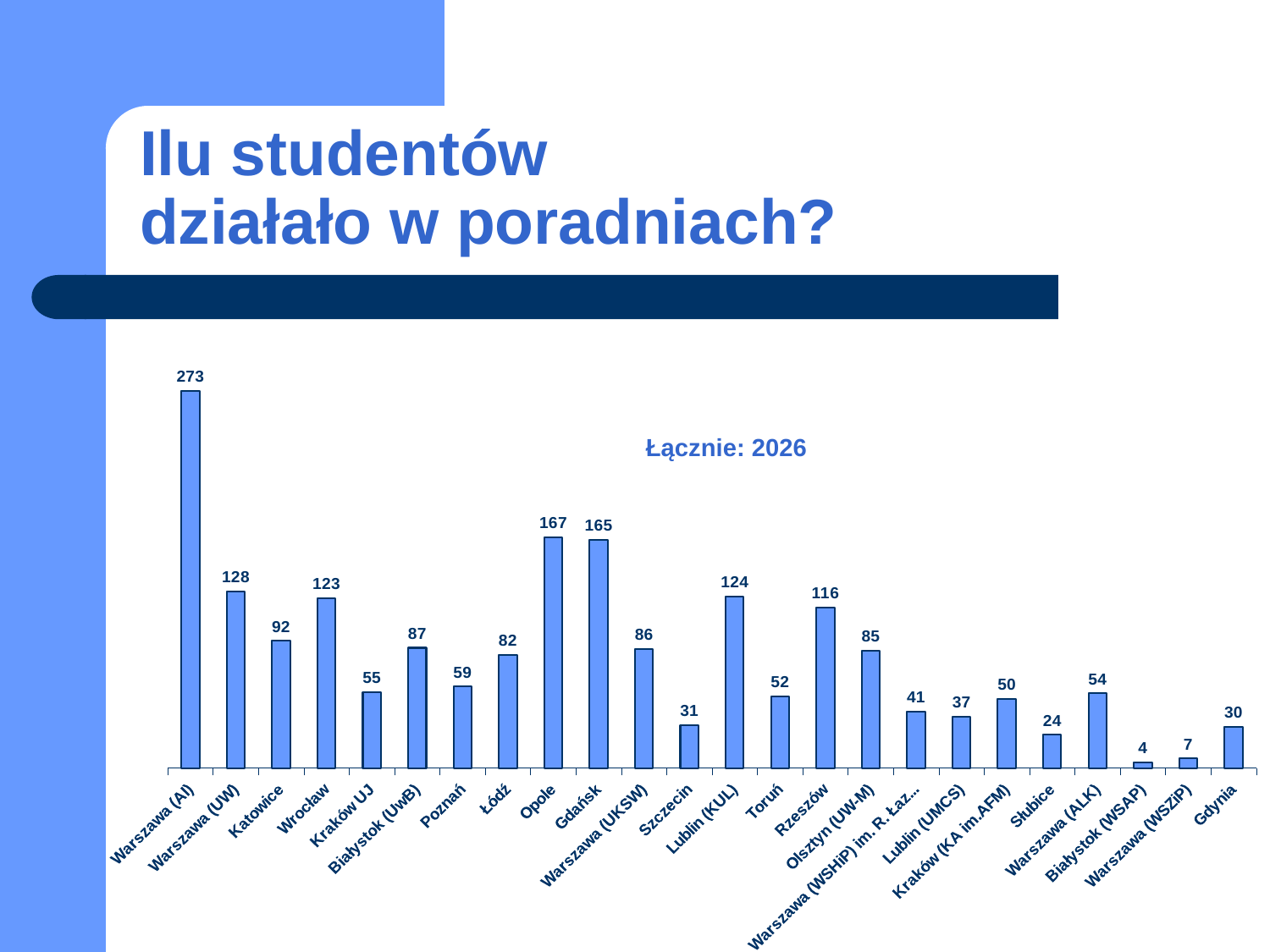
Which category has the lowest value? Białystok (WSAP) Which is larger, the value for Wrocław or the value for Katowice? Wrocław What value is shown for Szczecin? 31 What is the difference between the values for Rzeszów and Toruń? 64 What value is shown for Lublin (KUL)? 124 What total is stated in the text label inside the chart area? Łącznie: 2026 What kind of chart is shown on the slide? bar chart What is the difference between the values for Warszawa (AI) and Warszawa (UW)? 145 How many categories are shown on the x axis? 24 How many students are shown for Opole? 167 Which category has the highest value? Warszawa (AI) Which is larger, the value for Gdynia or the value for Słubice? Gdynia